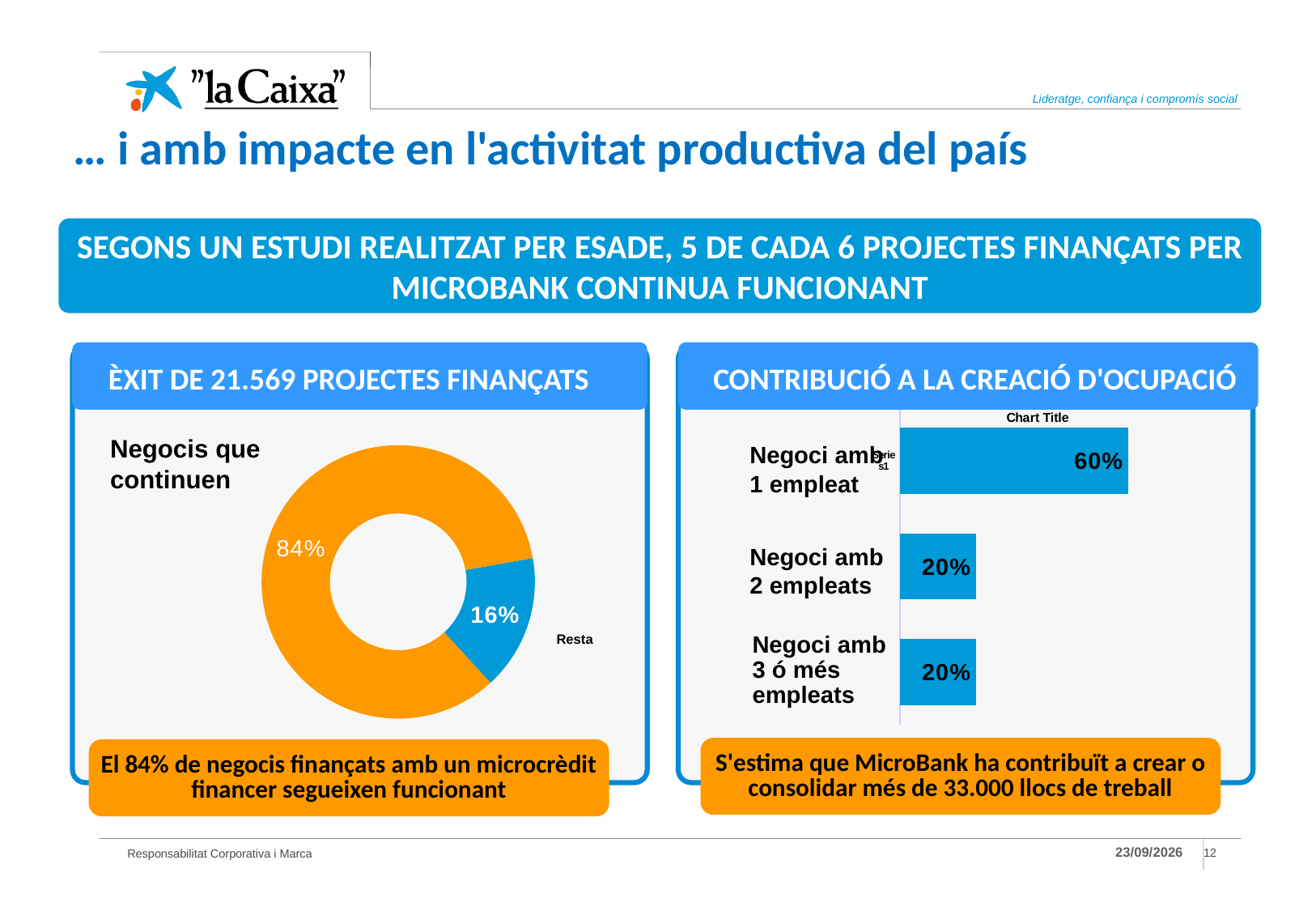
In the right chart (CONTRIBUCIÓ A LA CREACIÓ D'OCUPACIÓ), what is the value for 'Negoci amb 2 empleats'? 20% In the left chart (ÈXIT DE 21.569 PROJECTES FINANÇATS), which slice is larger, 'Negocis que continuen' or 'Resta'? Negocis que continuen In the left chart (ÈXIT DE 21.569 PROJECTES FINANÇATS), what share is labelled for 'Resta'? 16% In the left chart (ÈXIT DE 21.569 PROJECTES FINANÇATS), how many slices does the doughnut have? 2 In the left chart (ÈXIT DE 21.569 PROJECTES FINANÇATS), what is the difference in percentage points between 'Negocis que continuen' and 'Resta'? 68 percentage points In the left chart (ÈXIT DE 21.569 PROJECTES FINANÇATS), what share is labelled for 'Negocis que continuen'? 84% In the right chart (CONTRIBUCIÓ A LA CREACIÓ D'OCUPACIÓ), what is the difference between 'Negoci amb 1 empleat' and 'Negoci amb 3 ó més empleats'? 40 percentage points In the right chart (CONTRIBUCIÓ A LA CREACIÓ D'OCUPACIÓ), which category has the highest value? Negoci amb 1 empleat In the right chart (CONTRIBUCIÓ A LA CREACIÓ D'OCUPACIÓ), what is the value for 'Negoci amb 1 empleat'? 60% What kind of chart is shown in the left panel (ÈXIT DE 21.569 PROJECTES FINANÇATS)? Doughnut (pie) chart What kind of chart is shown in the right panel (CONTRIBUCIÓ A LA CREACIÓ D'OCUPACIÓ)? Bar chart In the right chart (CONTRIBUCIÓ A LA CREACIÓ D'OCUPACIÓ), how many categories are plotted? 3